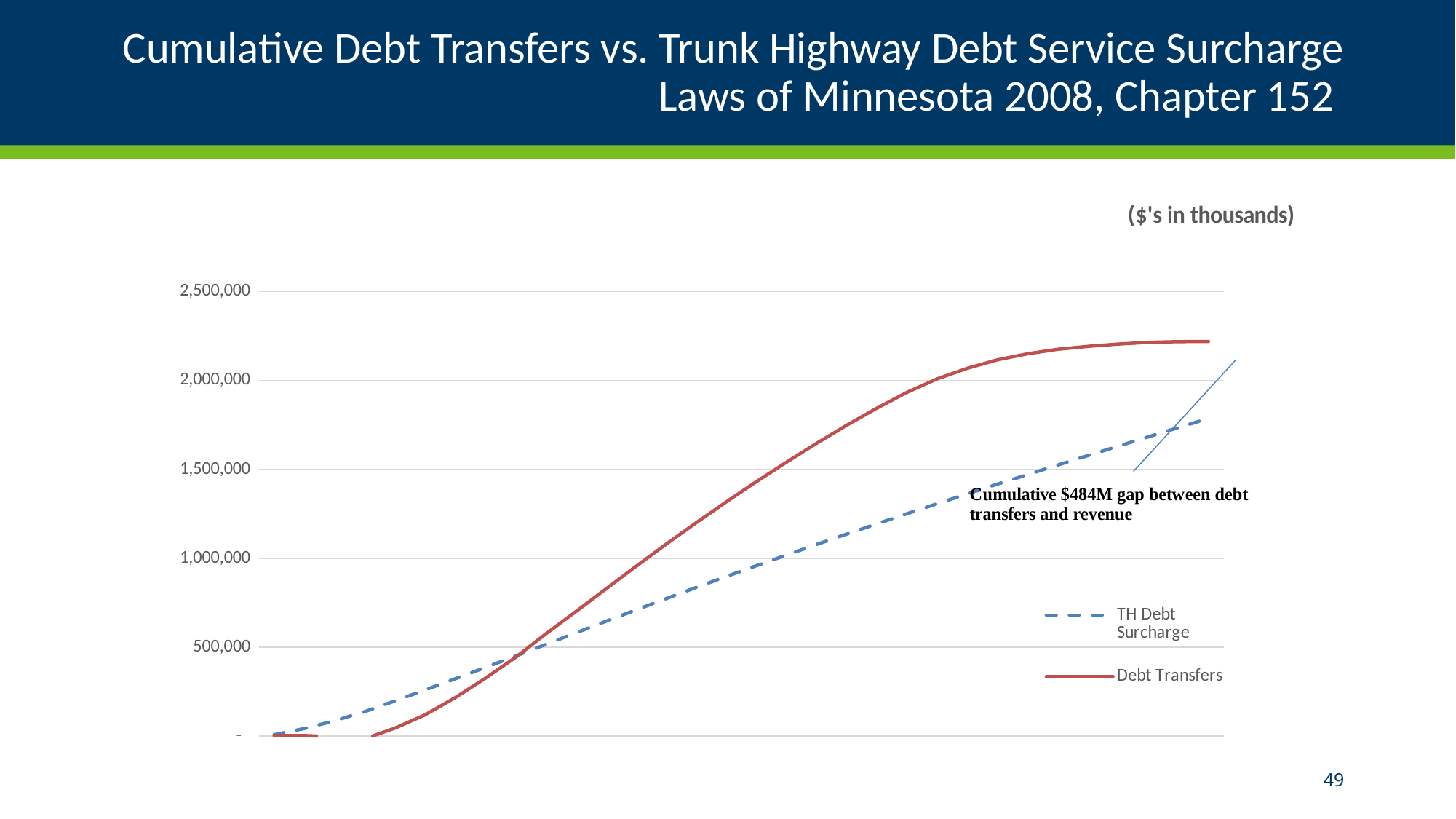
According to the annotation on the chart, what is the cumulative gap between debt transfers and revenue? $484M Which series is drawn with a solid red line? Debt Transfers Does the Debt Transfers line generally rise or fall from left to right? Rise Is the final value of the TH Debt Surcharge line greater or less than 1,500,000? greater How many series does the legend list? 2 At the right end of the chart, which series is higher: Debt Transfers or TH Debt Surcharge? Debt Transfers Which series is drawn with a dashed line? TH Debt Surcharge What kind of chart is shown on the slide? Line chart Is the final value of the Debt Transfers line greater or less than 2,000,000? greater Is the final value of the TH Debt Surcharge line greater or less than 2,000,000? less Does the TH Debt Surcharge line generally rise or fall from left to right? Rise What is the highest value shown on the vertical axis? 2,500,000